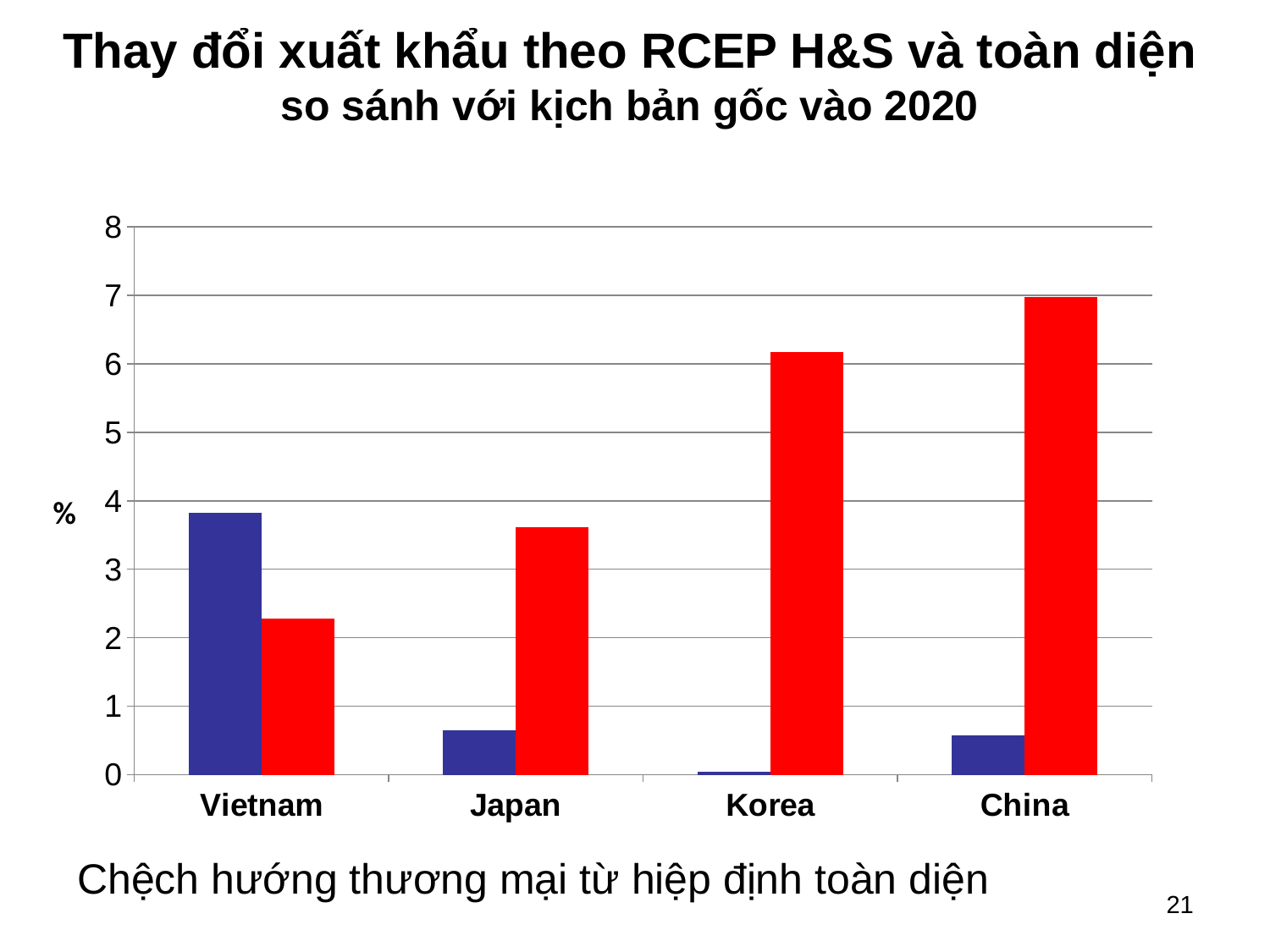
How many countries are shown on the x axis of the chart? 4 For Vietnam, which bar is taller, the blue one or the red one? blue What kind of chart is shown on the slide? bar chart Is the red bar for Korea greater or less than 6? greater What label is shown on the vertical axis of the chart? % Which country has the tallest blue bar? Vietnam Is the blue bar for Japan greater or less than 1? less Do the red bars rise or fall from Vietnam to China along the x axis? rise Which country has the shortest red bar? Vietnam Which country has the shortest blue bar? Korea Is the red bar for China greater or less than 6? greater Which country has the tallest red bar? China